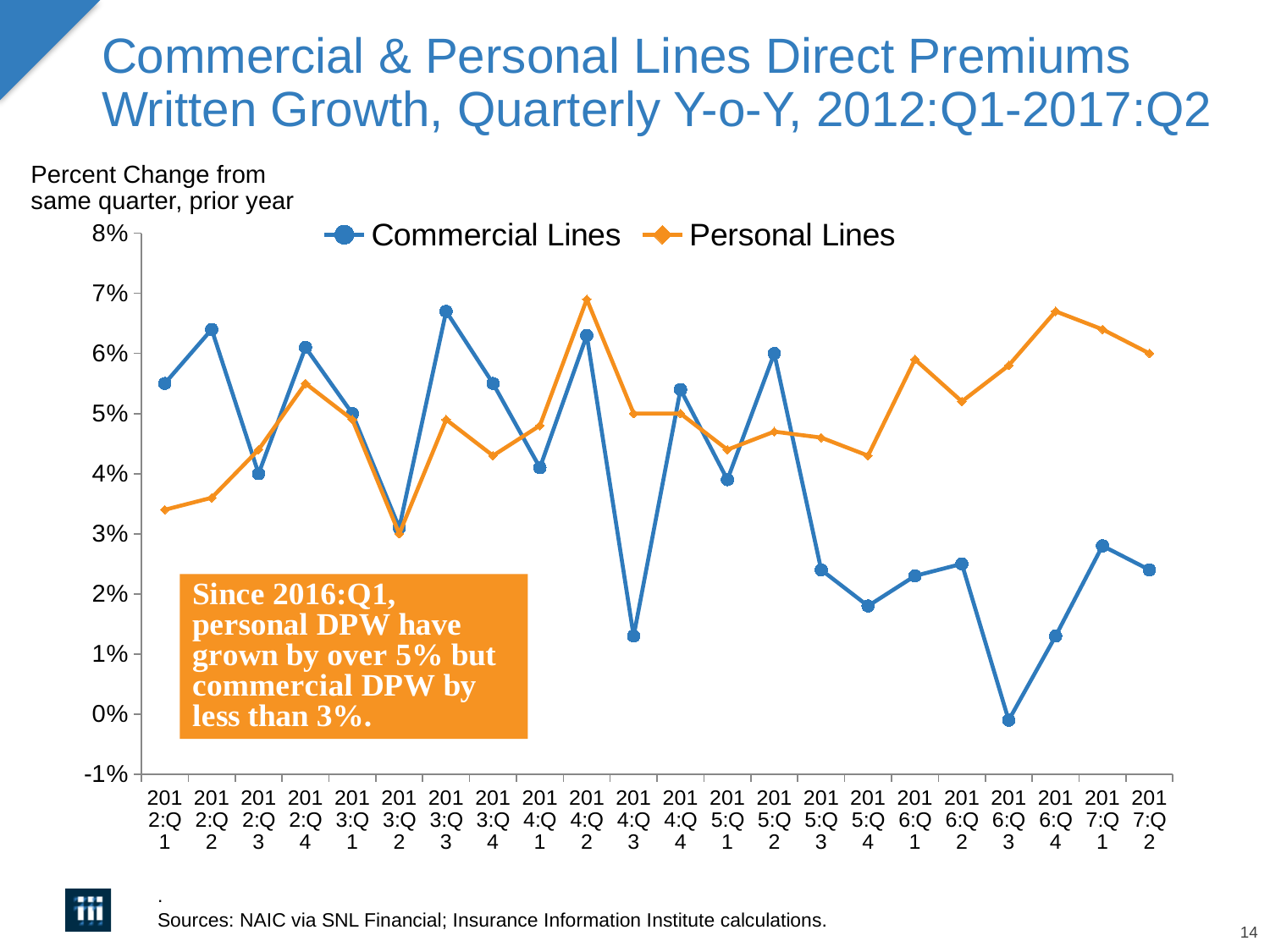
In 2016:Q4, which series has the larger value, Commercial Lines or Personal Lines? Personal Lines What are the two series named in the legend? Commercial Lines and Personal Lines How many series does the legend list? 2 In which quarter does the Personal Lines series reach its highest value? 2014:Q2 How many quarters are plotted along the x axis? 22 In which quarter does the Commercial Lines series reach its lowest value? 2016:Q3 Does the Commercial Lines series rise or fall from 2015:Q2 to 2016:Q3? fall What kind of chart is shown on the slide? line chart Is the Personal Lines value for 2016:Q4 greater or less than 6%? greater In which quarter does the Personal Lines series reach its lowest value? 2013:Q2 Is the Commercial Lines value for 2014:Q3 greater or less than 2%? less